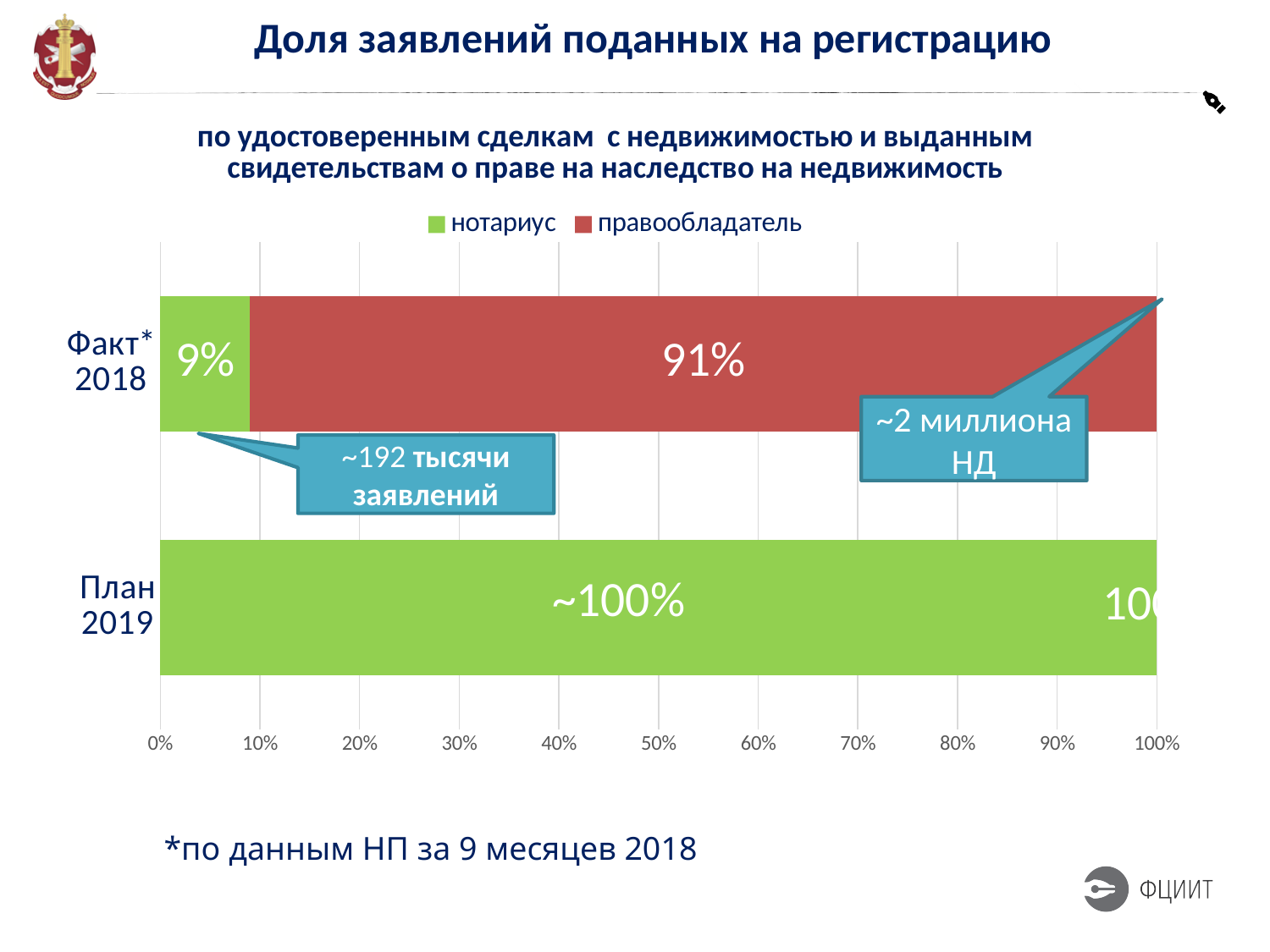
What is the total of the Факт* 2018 stacked bar? 100% Does the share for нотариус rise or fall from Факт* 2018 to План 2019? Rise In the Факт* 2018 bar, what is the difference between the правообладатель value and the нотариус value? 82 percentage points What is the value for нотариус in the Факт* 2018 bar? 9% In the Факт* 2018 bar, which series has the larger share: нотариус or правообладатель? правообладатель How many series does the legend list? 2 What is the value for правообладатель in the Факт* 2018 bar? 91% Is the value for нотариус in the План 2019 bar greater or less than 90%? greater What are the two series named in the legend? нотариус and правообладатель How many categories (bars) are shown on the chart? 2 Which colour represents the нотариус series? Green What kind of chart is shown on the slide? Stacked bar chart